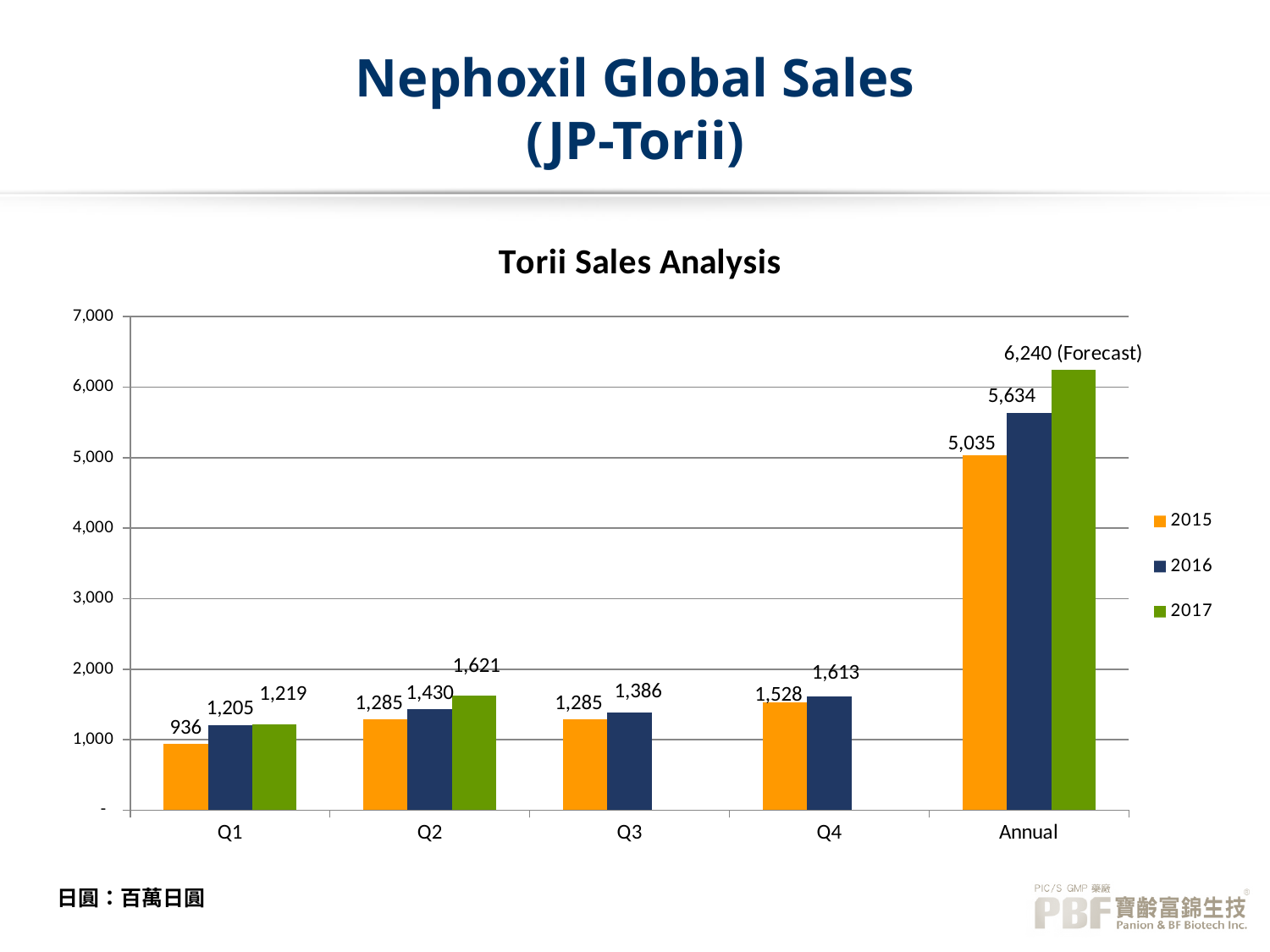
Which quarter has the highest 2015 value? Q4 What kind of chart is shown? Bar chart What is the 2017 Annual value? 6,240 (Forecast) What is the 2015 value for Q1? 936 How many categories are shown on the x axis? 5 Which quarter has the lowest 2016 value? Q1 How many series does the legend list? 3 What is the 2016 value for Q3? 1,386 Which is larger, the 2016 value for Q2 or the 2016 value for Q4? 2016 value for Q4 What is the title of the chart? Torii Sales Analysis What is the 2017 value for Q2? 1,621 What is the difference between the 2016 and 2015 Annual values? 599